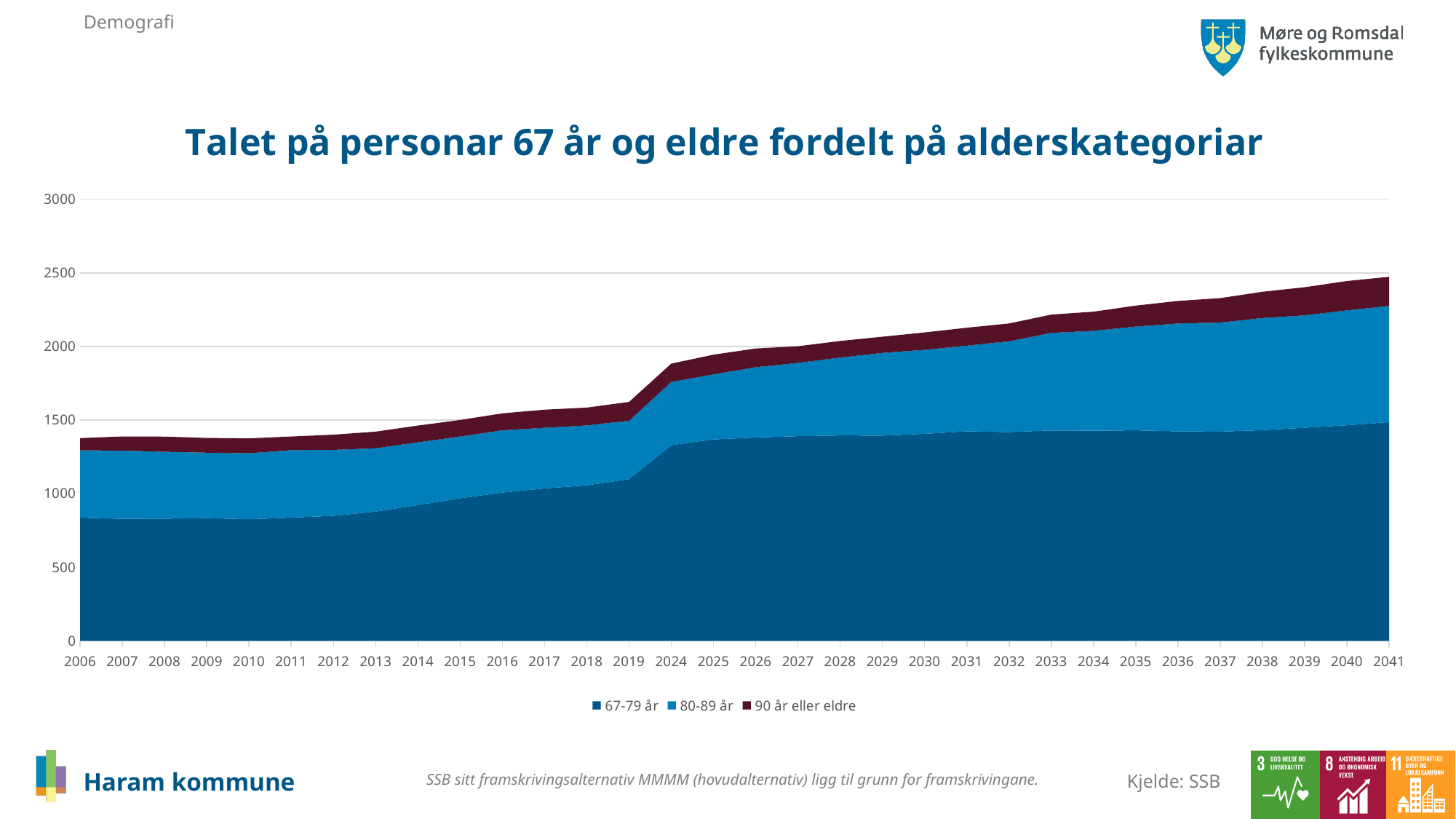
Does the total number of persons 67 years and older rise or fall from 2006 to 2041? Rise Is the total value for 2041 greater or less than 2000? greater Which age categories are listed in the legend? 67-79 år, 80-89 år, 90 år eller eldre How many series does the legend list? 3 How many years are shown along the x axis? 32 Is the value for 67-79 år in 2041 greater or less than 1000? greater What kind of chart is shown on the slide? Stacked area chart Is the total value for 2024 greater or less than 1500? greater In 2041, which is larger: the value for 67-79 år or the value for 90 år eller eldre? 67-79 år What is the title of the chart? Talet på personar 67 år og eldre fordelt på alderskategoriar